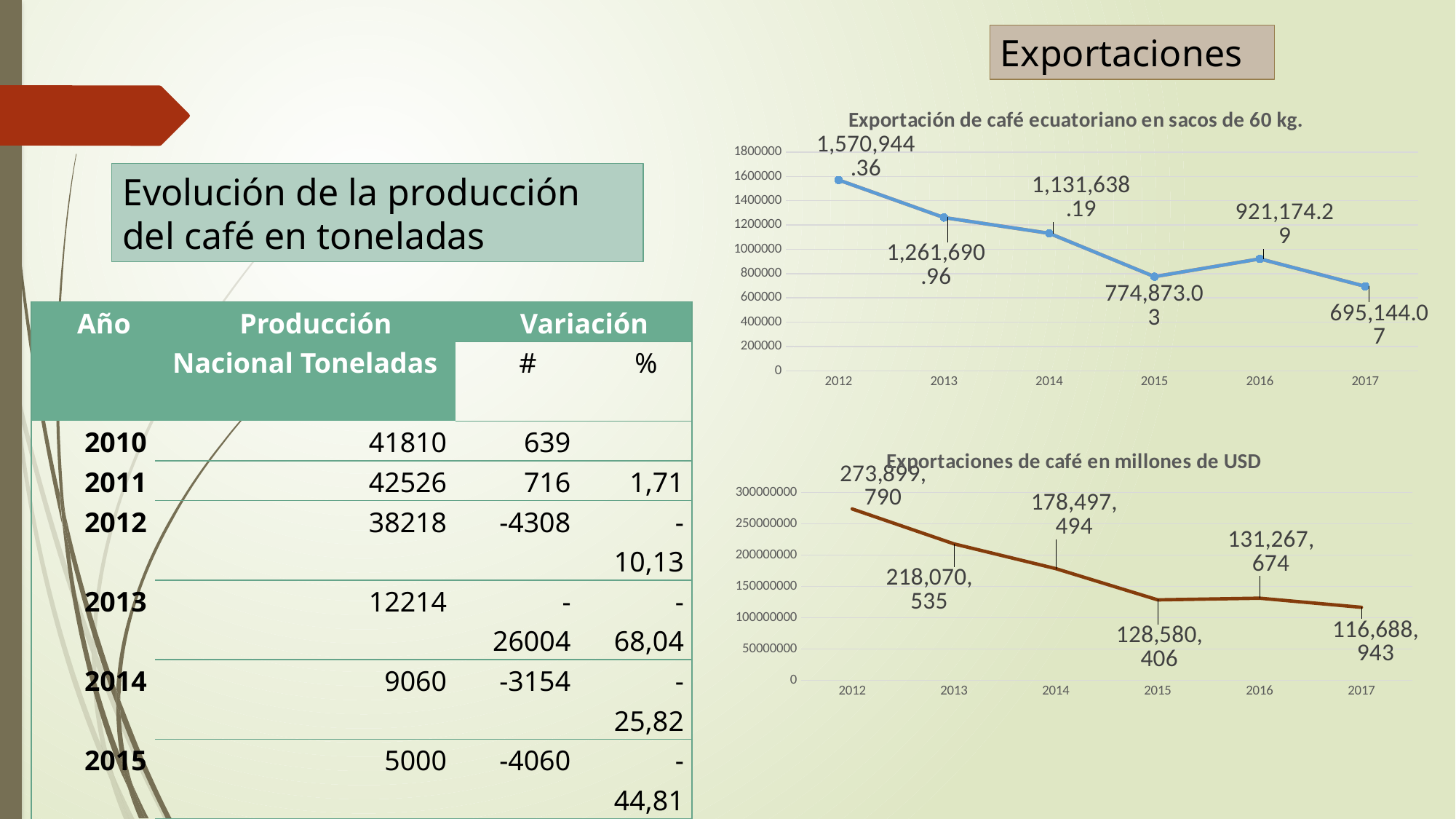
In the chart 'Exportación de café ecuatoriano en sacos de 60 kg.', how many years are plotted? 6 In the chart 'Exportaciones de café en millones de USD', what is the difference between the 2012 and 2017 values? 157,210,847 In the chart 'Exportación de café ecuatoriano en sacos de 60 kg.', what is the value for 2016? 921,174.29 In the chart 'Exportación de café ecuatoriano en sacos de 60 kg.', what is the difference between the 2016 and 2015 values? 146,301.26 In the chart 'Exportación de café ecuatoriano en sacos de 60 kg.', which year has the lowest value? 2017 In the chart 'Exportación de café ecuatoriano en sacos de 60 kg.', which year has the highest value? 2012 In the chart 'Exportación de café ecuatoriano en sacos de 60 kg.', what is the value for 2012? 1,570,944.36 In the chart 'Exportaciones de café en millones de USD', what is the value for 2017? 116,688,943 In the chart 'Exportaciones de café en millones de USD', what is the value for 2015? 128,580,406 What kind of chart is 'Exportaciones de café en millones de USD'? Line chart In the chart 'Exportaciones de café en millones de USD', is the value for 2016 larger or smaller than the value for 2015? Larger In the chart 'Exportaciones de café en millones de USD', do the values generally rise or fall from 2012 to 2017? Fall